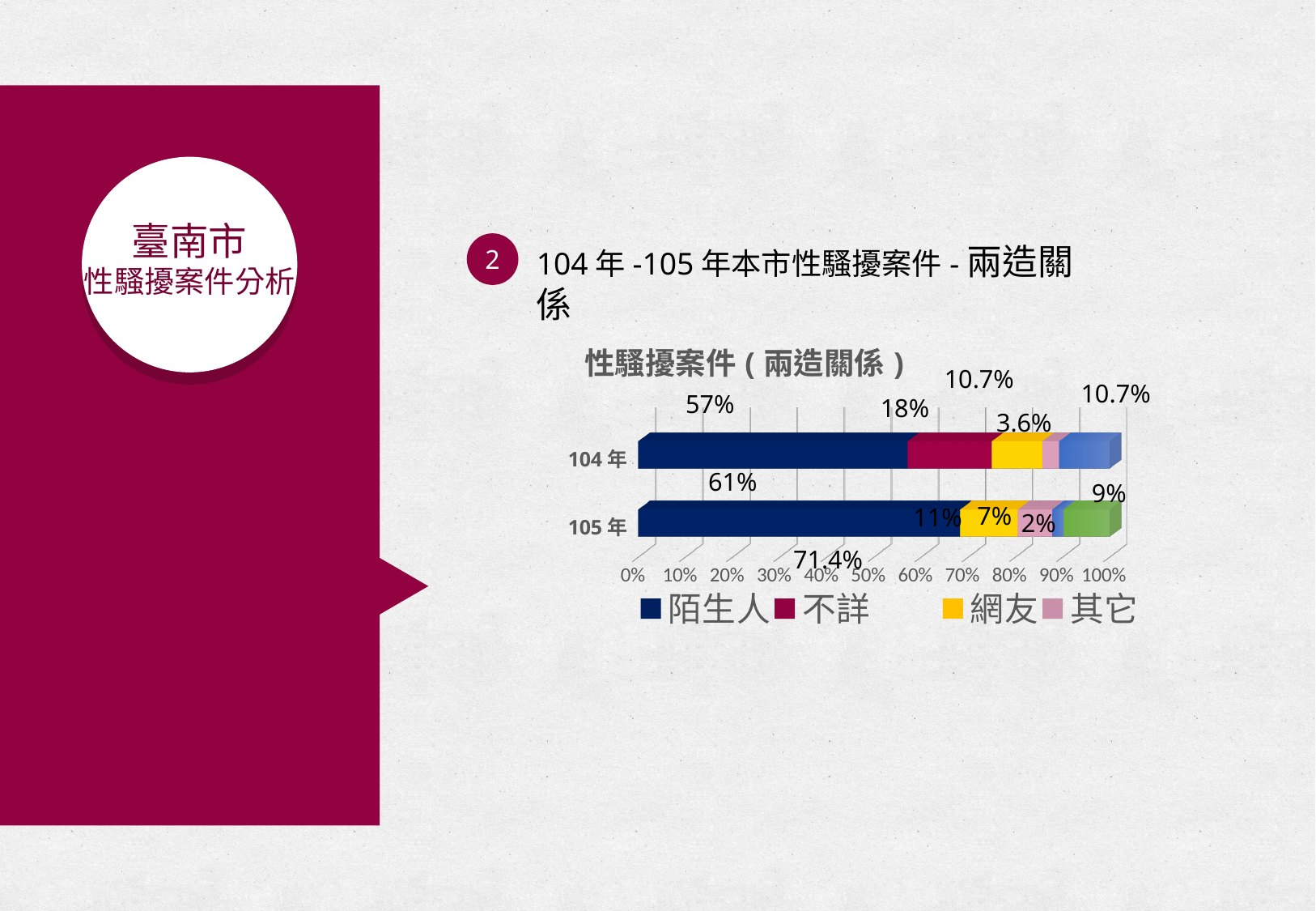
Is the value for 陌生人 in 105年 greater or less than 50%? greater In 104年, which is larger: 陌生人 or 不詳? 陌生人 How many series does the chart legend list? 4 What is the value for 不詳 in 104年? 18% What is the title of the chart? 性騷擾案件（兩造關係） What is the value for 網友 in 105年? 7% What kind of chart is shown on the slide? Stacked bar chart What is the value for 其它 in 105年? 2% How many year categories are plotted on the chart? 2 What is the value for 陌生人 in 104年? 57% Which series has the largest share in the 104年 bar? 陌生人 What is the difference between 陌生人 and 不詳 in 104年? 39%